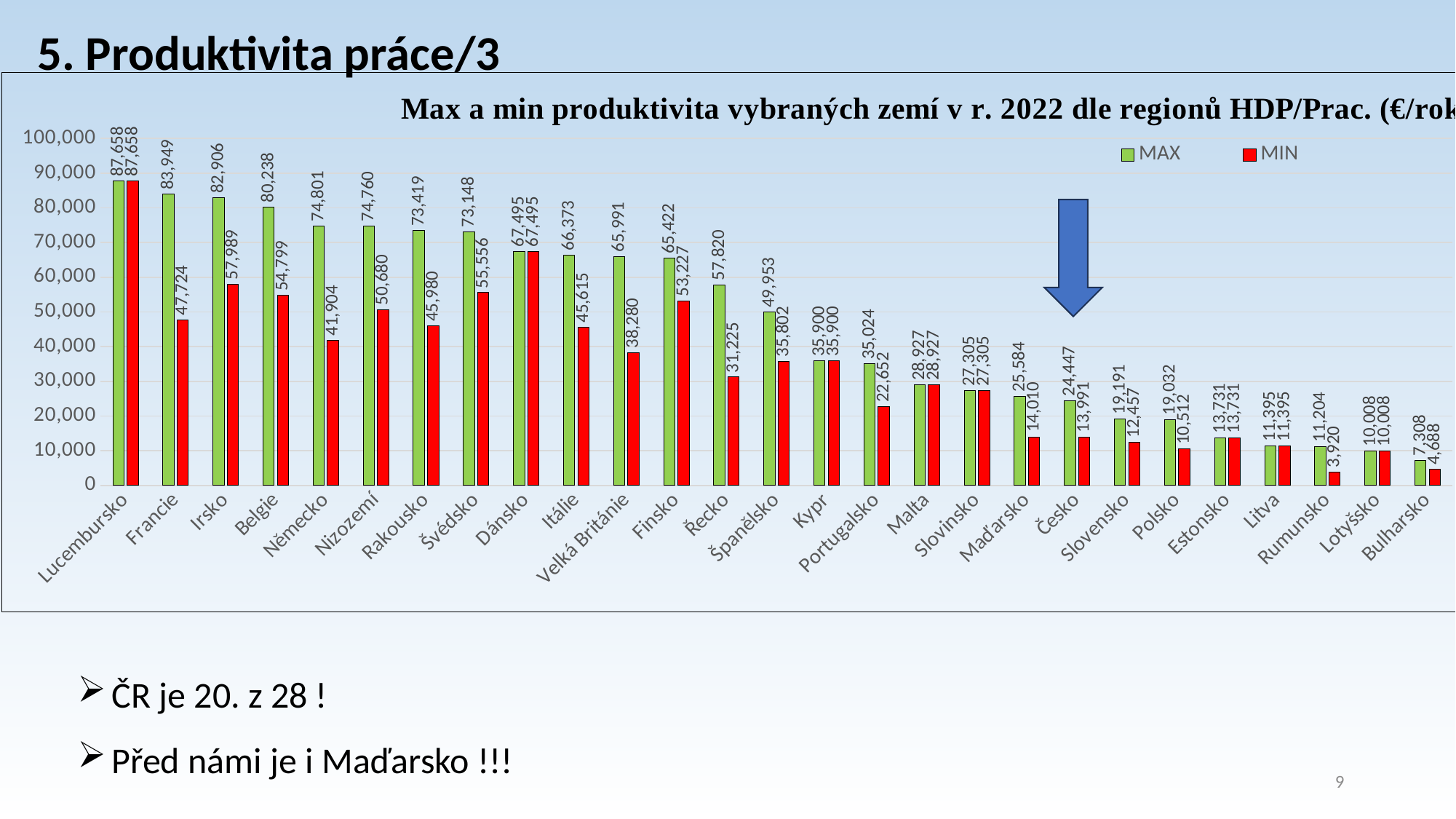
Which country has the lowest MIN value? Rumunsko Which country has the lowest MAX value? Bulharsko What is the MIN value for Rumunsko? 3,920 How many countries are shown on the x axis? 27 Do the MAX values rise or fall from left to right along the x axis? Fall Which country has the highest MAX value? Lucembursko How many series does the legend list? 2 What is the MAX value for Česko? 24,447 Which is larger, the MIN value for Irsko or the MIN value for Belgie? Irsko What kind of chart is shown on the slide? Bar chart What is the difference between the MAX and MIN values for Francie? 36,225 What is the MIN value for Německo? 41,904